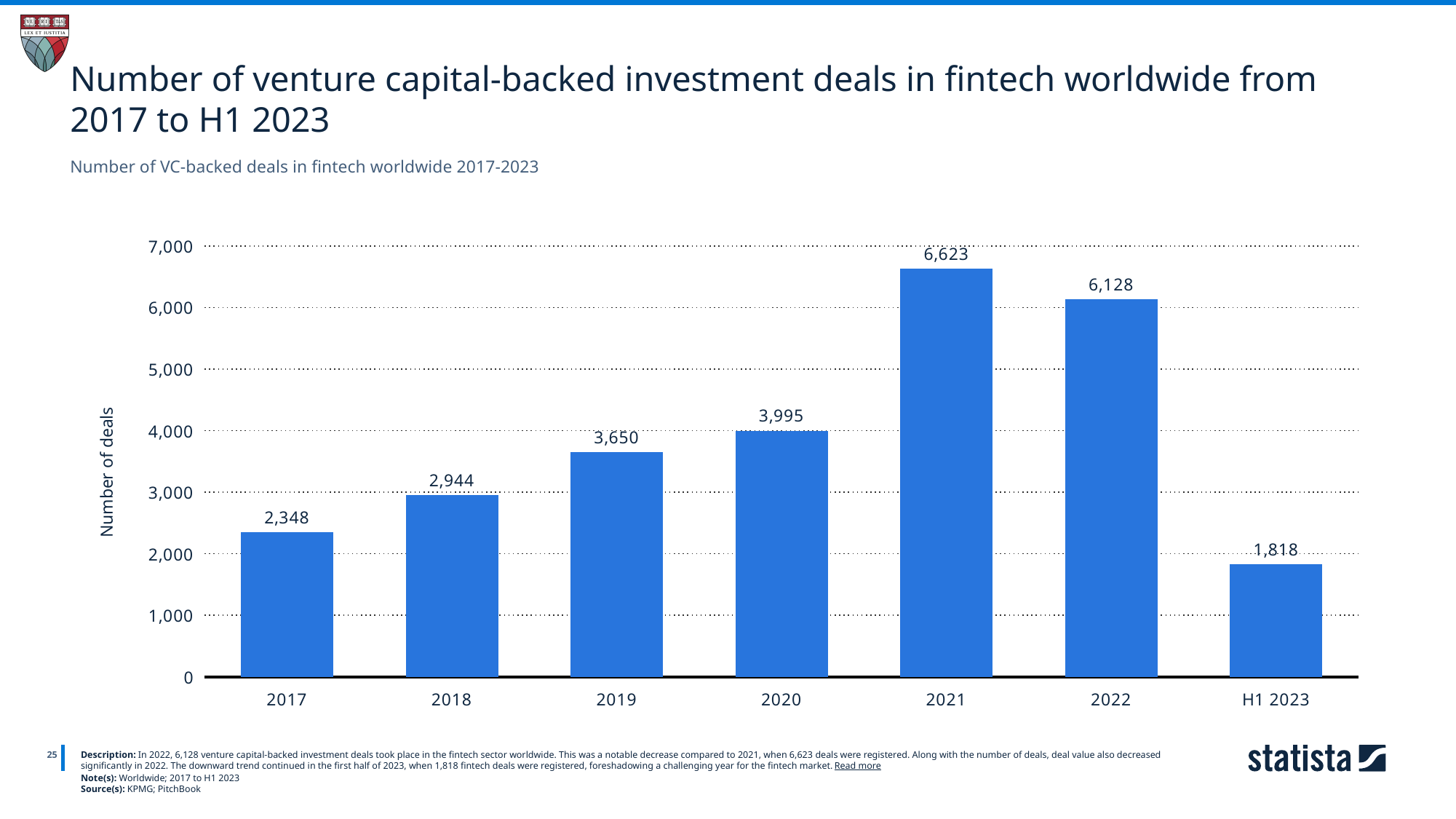
What is the value for 2017? 2,348 Which is larger, the value for 2020 or the value for 2019? 2020 What is the difference between the number of deals in 2021 and 2022? 495 Is the value for 2022 greater or less than 6,000? greater Which year has the highest number of deals? 2021 What is the label of the y axis? Number of deals How many VC-backed fintech deals were there in 2019? 3,650 By how much did the number of deals increase from 2017 to 2018? 596 What kind of chart is this? bar chart Which period has the lowest number of deals? H1 2023 What is the number of deals shown for H1 2023? 1,818 How many periods are shown on the x axis? 7